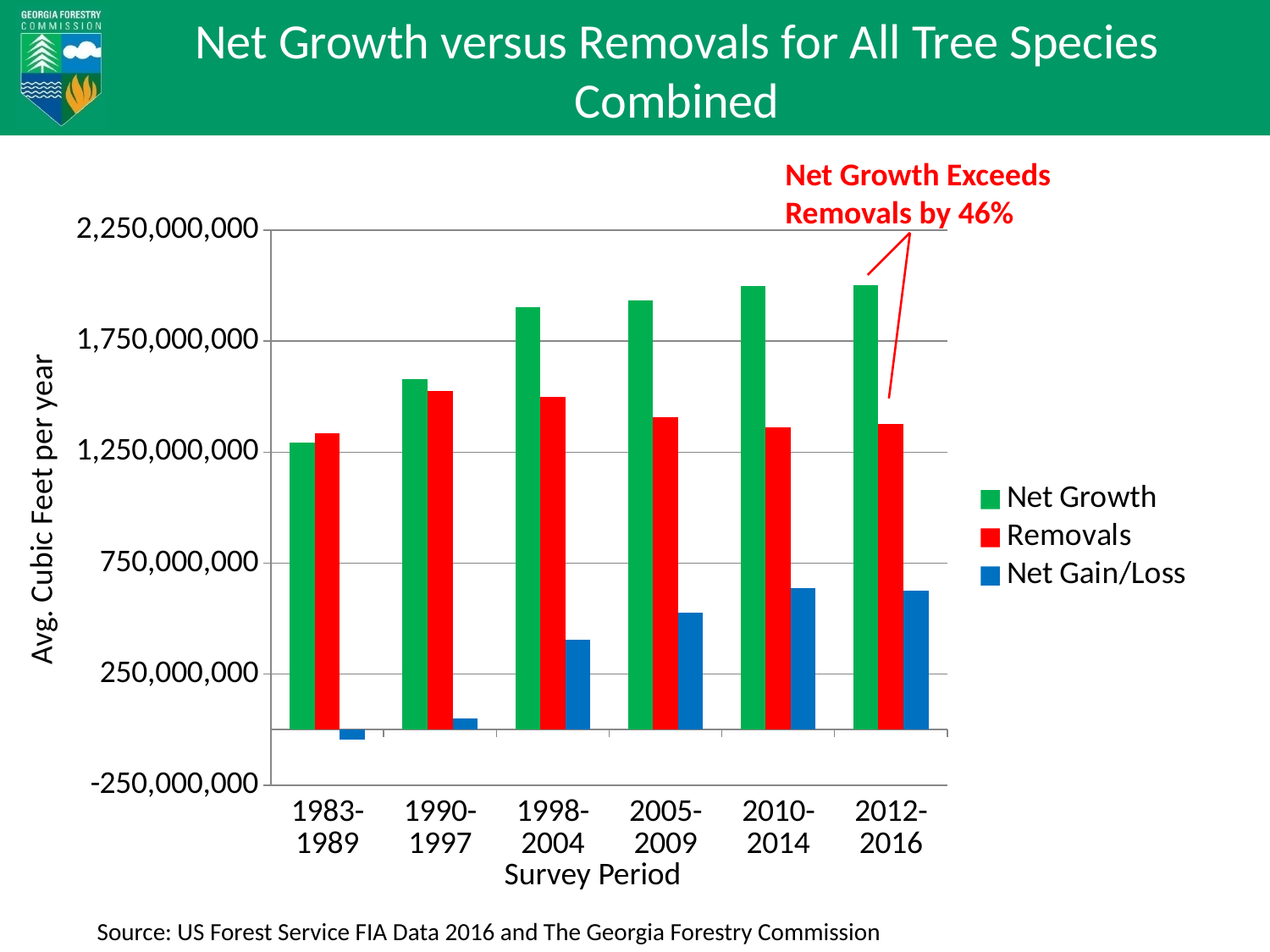
In the 1983-1989 survey period, which is larger, Net Growth or Removals? Removals In the 2005-2009 survey period, which is larger, Net Growth or Removals? Net Growth Is the Net Growth value for 2012-2016 greater or less than 1,750,000,000? greater How many series does the legend list? 3 According to the annotation on the chart, by what percentage does Net Growth exceed Removals? 46% What kind of chart is shown on the slide? bar chart Does the Net Growth series generally rise or fall across the survey periods from 1983-1989 to 2012-2016? rise Is the Removals value for 2010-2014 greater or less than 1,750,000,000? less Which survey period has the lowest Net Gain/Loss value? 1983-1989 Is the Net Gain/Loss value for 2005-2009 greater or less than 750,000,000? less How many survey periods are shown on the x axis? 6 Which survey period has the highest Removals value? 1990-1997